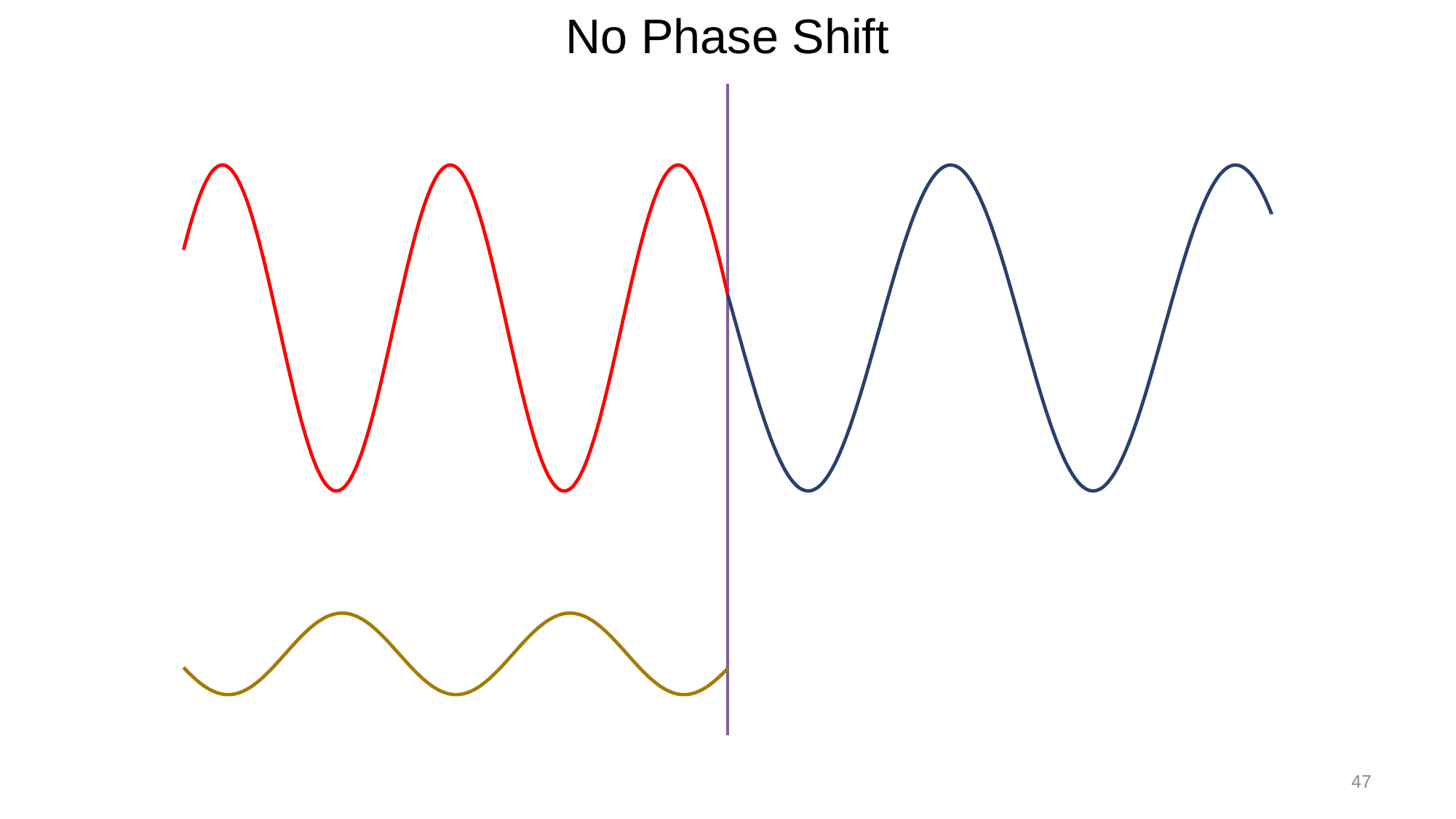
What kind of chart is shown on the slide? line chart Which wave has the larger amplitude, the red wave or the gold wave? red How many wave curves are drawn on the slide? 3 What is the title of the chart on the slide? No Phase Shift What colour is the wave drawn to the right of the vertical purple line? blue